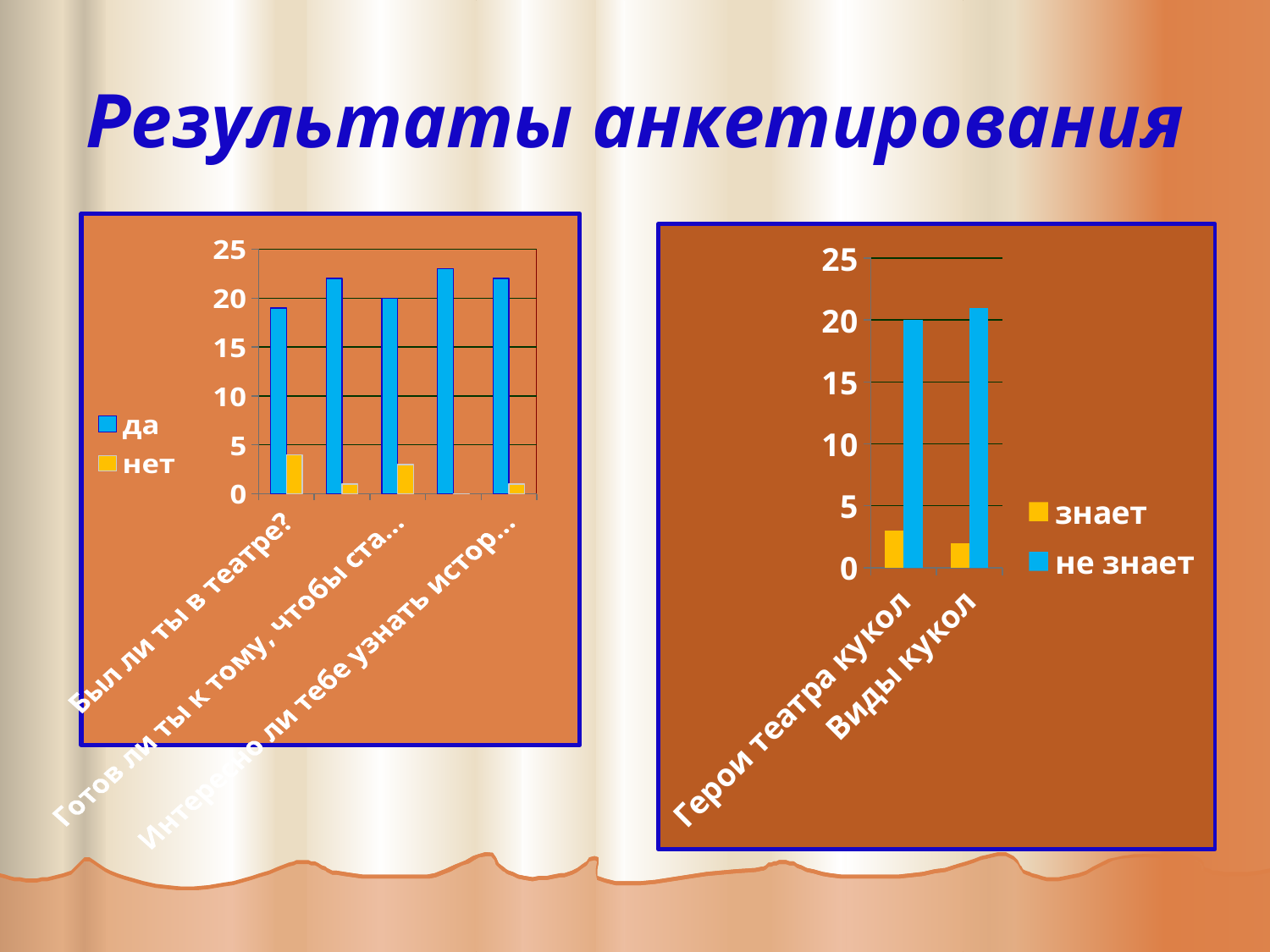
In the left chart, is the value of "да" for "Был ли ты в театре?" greater or less than 20? less In the right chart, for "Виды кукол", which is larger: "знает" or "не знает"? не знает In the right chart, is the value of "не знает" for "Виды кукол" greater or less than 20? greater In the left chart, is the value of "нет" for "Был ли ты в театре?" greater or less than 5? less How many series does the legend of the right chart list? 2 In the left chart, for "Был ли ты в театре?", which is larger: "да" or "нет"? да What kind of chart is the chart on the right of the slide? bar chart What are the two legend entries of the right chart? знает, не знает How many groups of bars are shown on the left chart? 5 How many categories are shown on the right chart? 2 What kind of chart is the chart on the left of the slide? bar chart How many series does the legend of the left chart list? 2